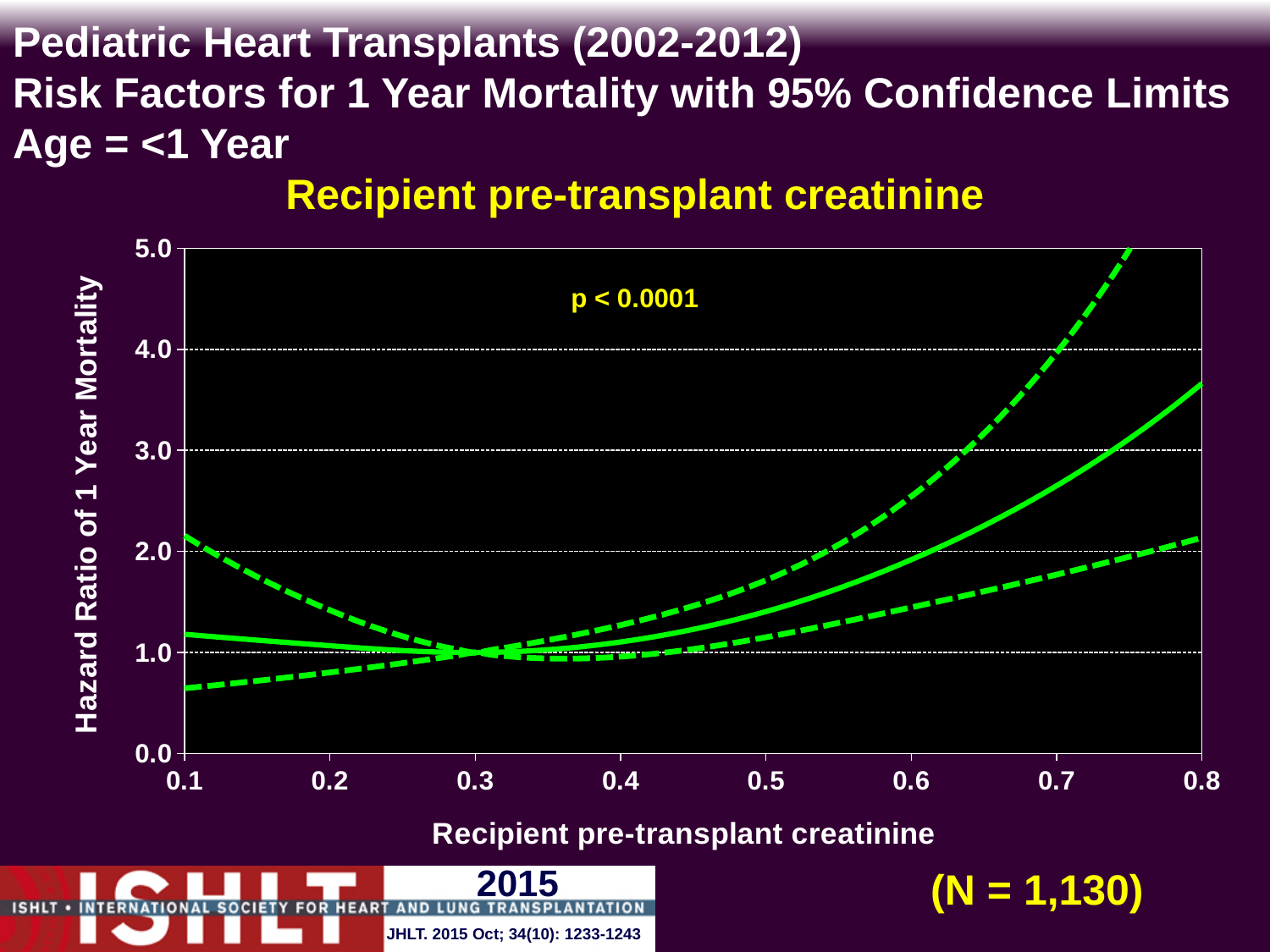
Is the lower dashed confidence limit at a creatinine of 0.1 greater or less than 1.0? less Is the upper dashed confidence limit at a creatinine of 0.6 greater or less than 2.0? greater How many lines are plotted on the chart? 3 Does the lower dashed confidence limit rise or fall as creatinine increases from 0.1 to 0.8? rise Does the solid hazard ratio line rise or fall as recipient pre-transplant creatinine increases from 0.3 to 0.8? rise At a creatinine of 0.1, which is larger: the upper dashed confidence limit or the lower dashed confidence limit? upper dashed confidence limit What is the title of the chart? Recipient pre-transplant creatinine Is the solid hazard ratio line at a creatinine of 0.8 greater or less than 3.0? greater What kind of chart is shown on the slide? line chart What p-value is printed on the chart? p < 0.0001 At a creatinine of 0.8, which is larger: the solid hazard ratio line or the lower dashed confidence limit? solid hazard ratio line